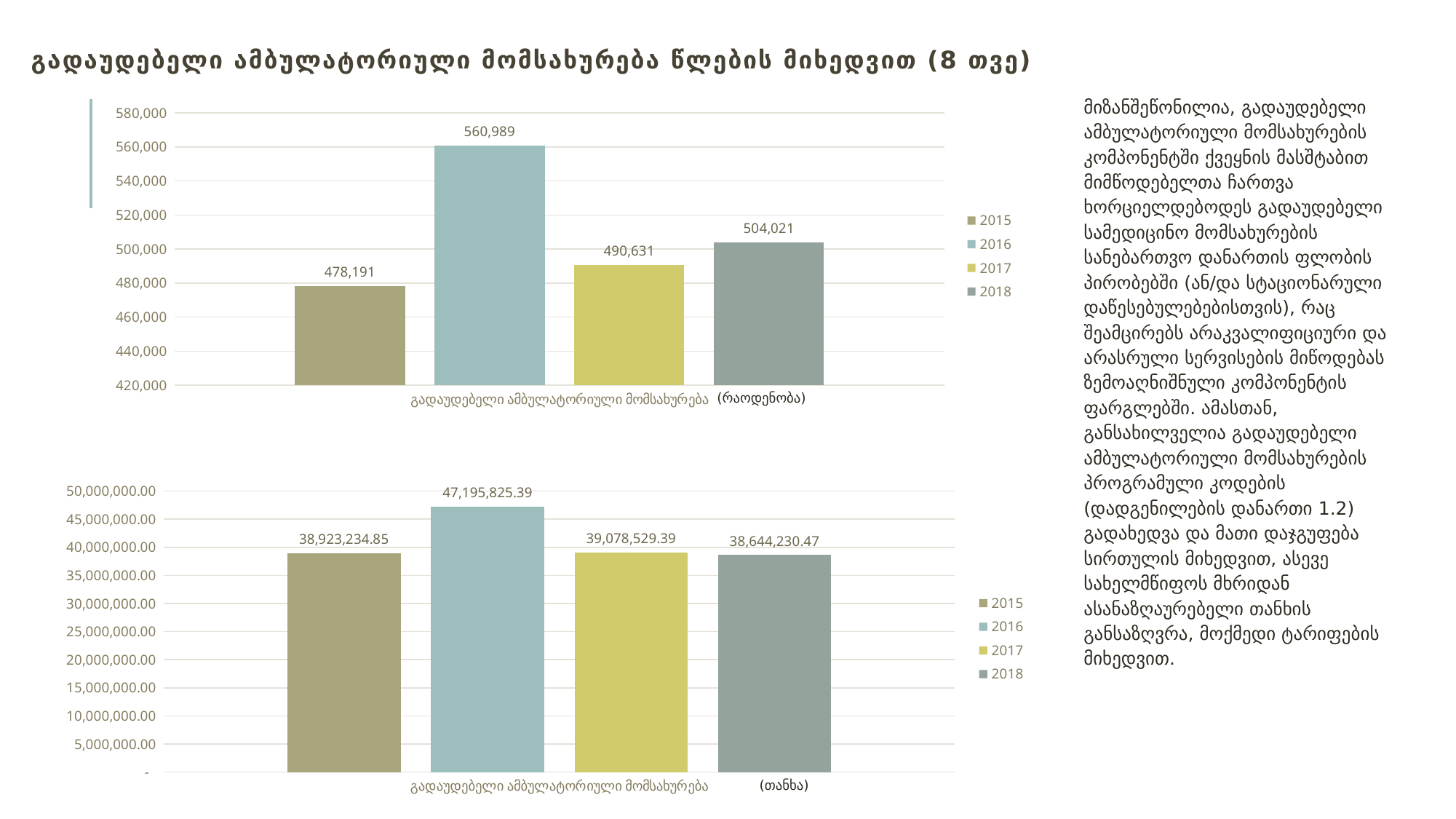
What kind of chart is the bottom chart? bar chart How many series does the legend of the top chart list? 4 In the top chart, which year has the highest value? 2016 In the top chart, what is the difference between the 2016 value and the 2015 value? 82,798 In the top chart, which year has the lowest value? 2015 In the bottom chart, which is larger, the value for 2017 or the value for 2018? 2017 In the bottom chart, what is the value for 2015? 38,923,234.85 In the bottom chart, what is the difference between the 2016 value and the 2015 value? 8,272,590.54 In the bottom chart, which year has the lowest value? 2018 In the top chart, what is the value for 2016? 560,989 In the bottom chart, what is the value for 2017? 39,078,529.39 In the top chart, what is the value for 2018? 504,021